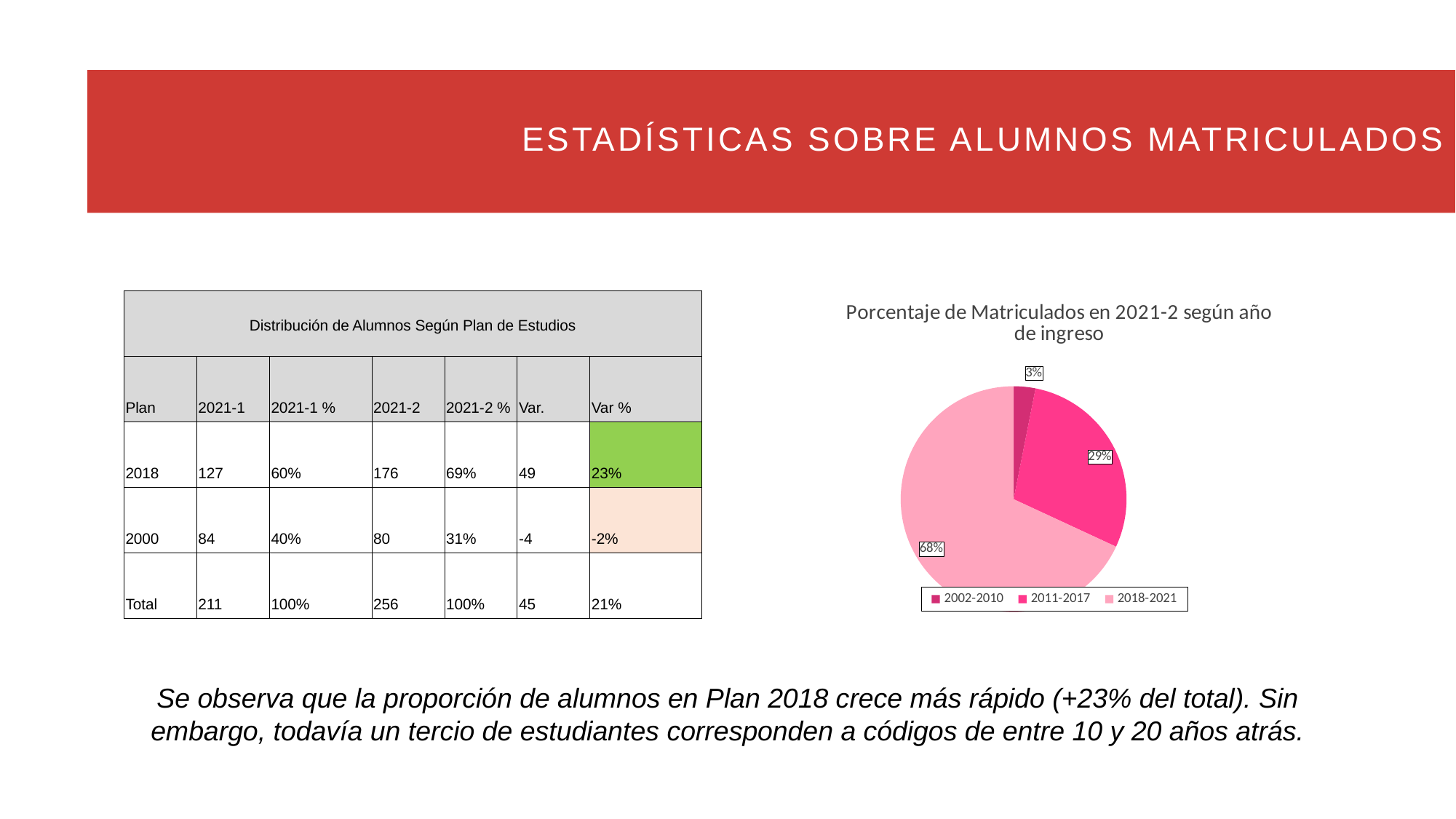
How many entries does the pie chart's legend list? 3 What is the difference in percentage points between the 2018-2021 slice and the 2011-2017 slice? 39 What share of the pie does the 2011-2017 slice represent? 29% How many slices does the pie chart have? 3 Which entry-year group has the smallest slice of the pie? 2002-2010 What is the combined share of the 2002-2010 and 2011-2017 slices? 32% What kind of chart is shown on the slide? pie chart What is the title of the pie chart? Porcentaje de Matriculados en 2021-2 según año de ingreso What share of the pie does the 2018-2021 slice represent? 68% Which entry-year group has the largest slice of the pie? 2018-2021 What share of the pie does the 2002-2010 slice represent? 3% Which slice is larger, 2011-2017 or 2002-2010? 2011-2017